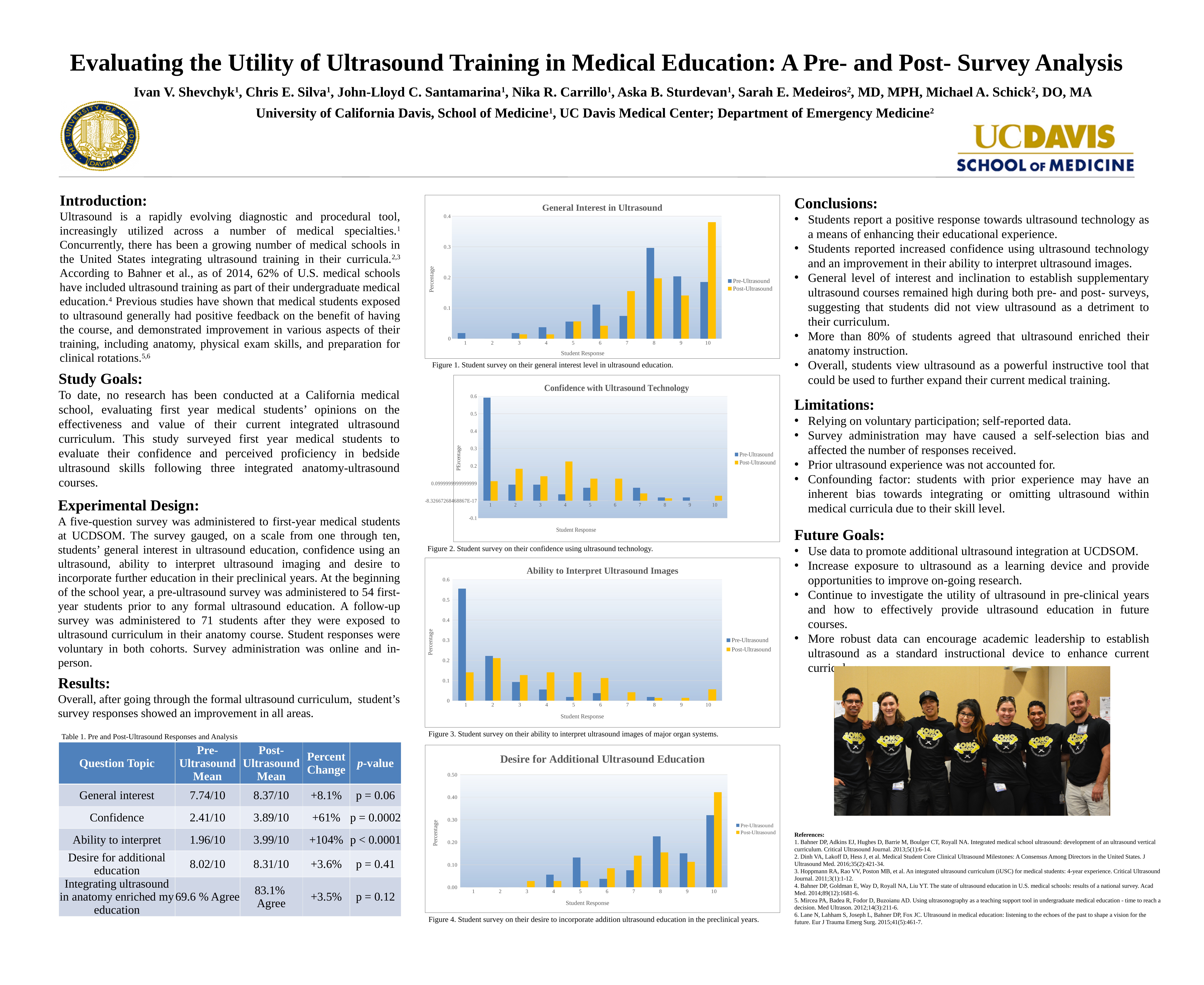
In the 'Confidence with Ultrasound Technology' chart, which student response has the highest Post-Ultrasound value? 4 In the 'General Interest in Ultrasound' chart, which student response has the highest Pre-Ultrasound value? 8 In the 'Ability to Interpret Ultrasound Images' chart, which is larger for student response 1: the Pre-Ultrasound value or the Post-Ultrasound value? Pre-Ultrasound In the 'General Interest in Ultrasound' chart, how many student response categories are shown on the x axis? 10 In the 'Desire for Additional Ultrasound Education' chart, is the Post-Ultrasound value for student response 10 greater or less than 0.40? greater What kind of chart is the 'Desire for Additional Ultrasound Education' chart? Bar chart In the 'Confidence with Ultrasound Technology' chart, is the Pre-Ultrasound value for student response 1 greater or less than 0.5? greater How many series does the legend of the 'Desire for Additional Ultrasound Education' chart list? 2 In the 'Confidence with Ultrasound Technology' chart, which student response has the highest Pre-Ultrasound value? 1 In the 'Ability to Interpret Ultrasound Images' chart, is the Pre-Ultrasound value for student response 1 greater or less than 0.5? greater